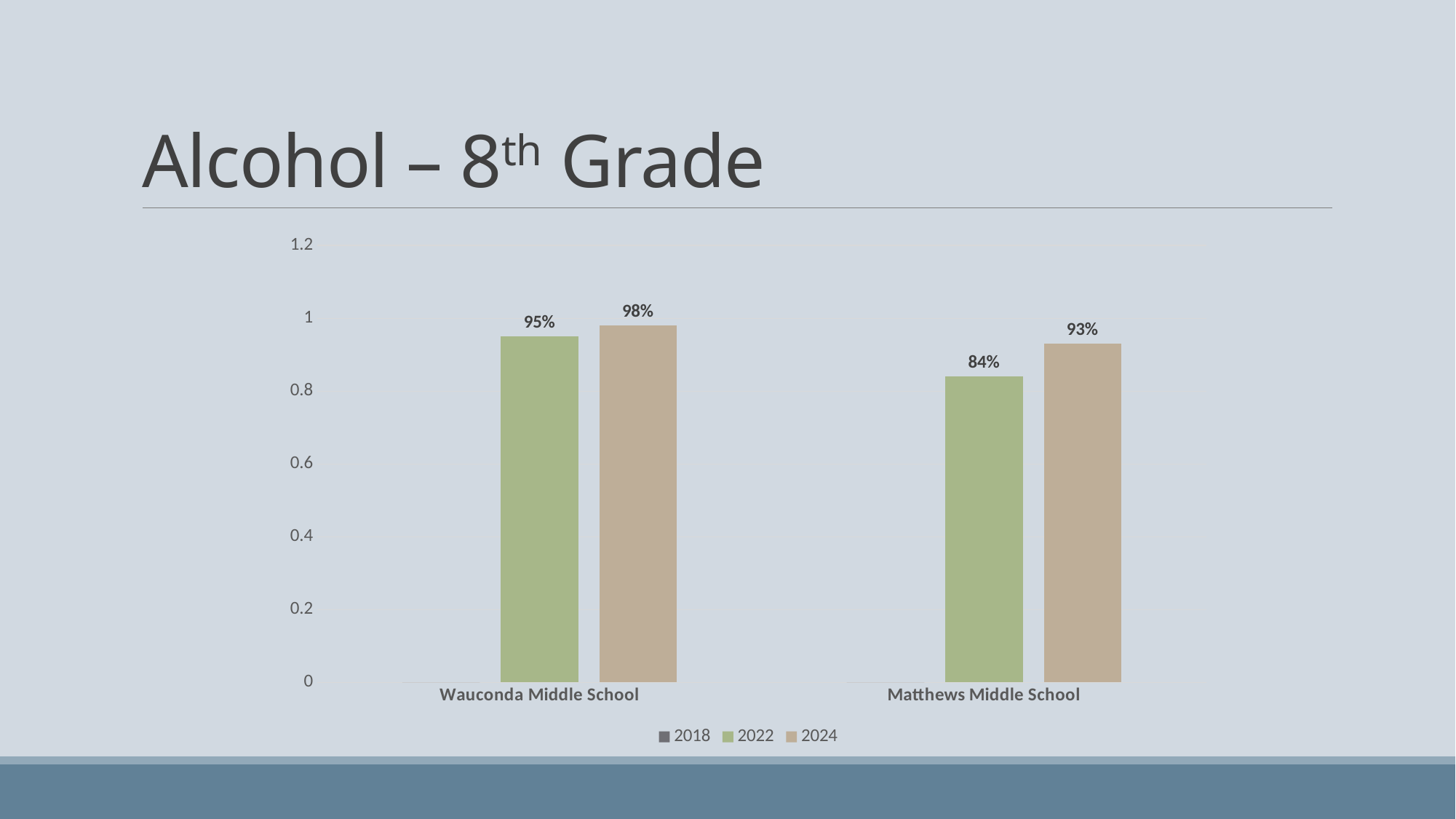
Which is larger for Wauconda Middle School, the 2022 value or the 2024 value? 2024 What is the 2024 value for Matthews Middle School? 93% Which school has the highest 2024 value? Wauconda Middle School What kind of chart is shown on the slide? Bar chart Which school has the lowest 2022 value? Matthews Middle School What is the 2022 value for Matthews Middle School? 84% How many series does the legend list? 3 What is the 2022 value for Wauconda Middle School? 95% What is the 2024 value for Wauconda Middle School? 98% What is the difference between the 2024 and 2022 values for Matthews Middle School? 9% What is the difference between the 2022 values for Wauconda Middle School and Matthews Middle School? 11% How many schools are shown on the x axis? 2